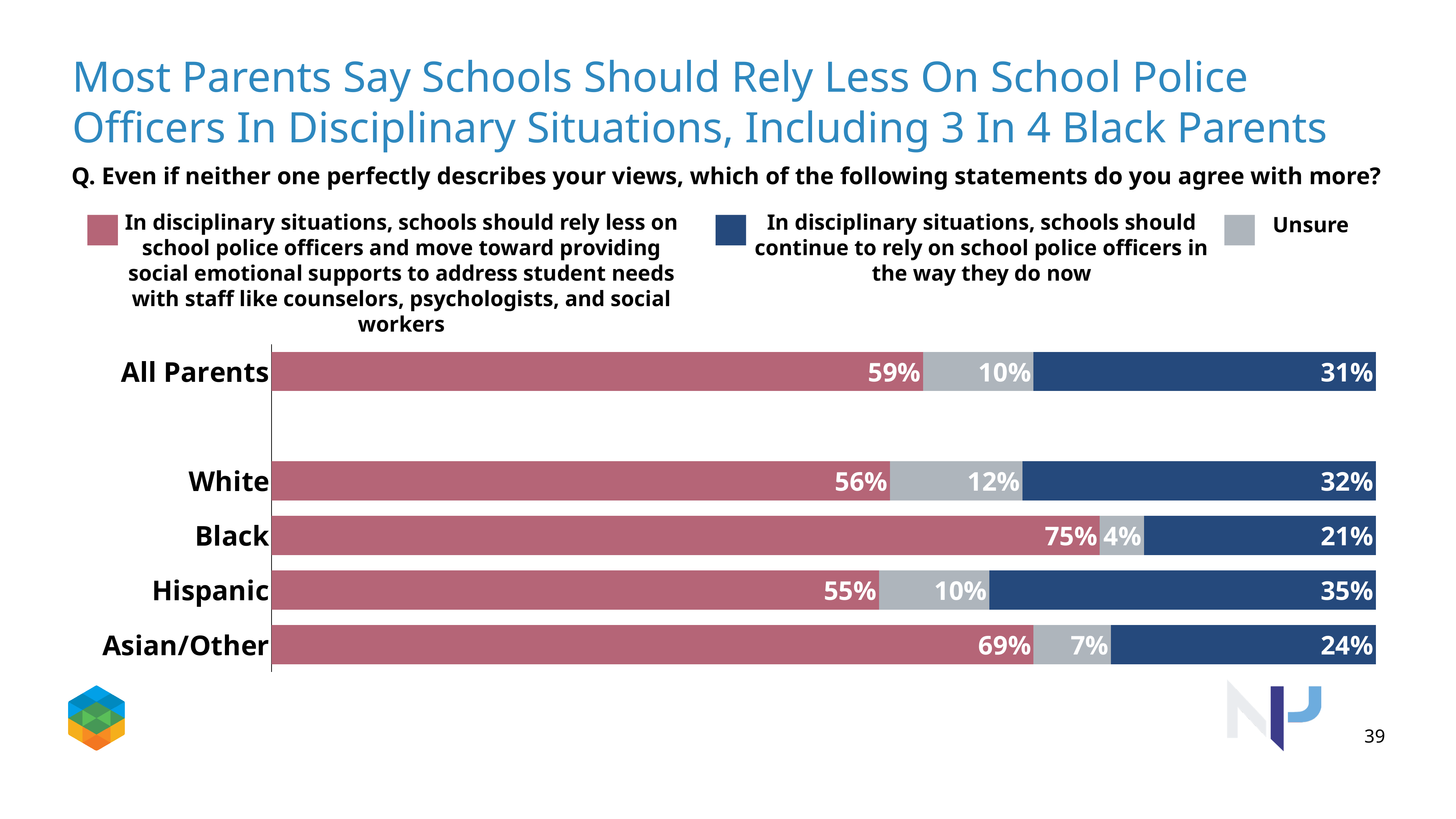
What percentage of Black parents say schools should rely less on school police officers? 75% How many groups are shown on the chart? 5 What percentage of All Parents say schools should rely less on school police officers? 59% What percentage of Hispanic parents say schools should continue to rely on school police officers in the way they do now? 35% What colour represents the 'Unsure' response in the chart? Gray Which group has the lowest share saying schools should continue to rely on school police officers? Black What kind of chart is shown on the slide? Stacked bar chart Which is larger: the share of Asian/Other parents who say schools should rely less on school police officers, or the share of Hispanic parents who say the same? Asian/Other Which group has the highest share saying schools should rely less on school police officers? Black What percentage of White parents are unsure? 12% How many series does the legend list? 3 What is the difference between the share of Black parents and the share of White parents who say schools should rely less on school police officers? 19 percentage points